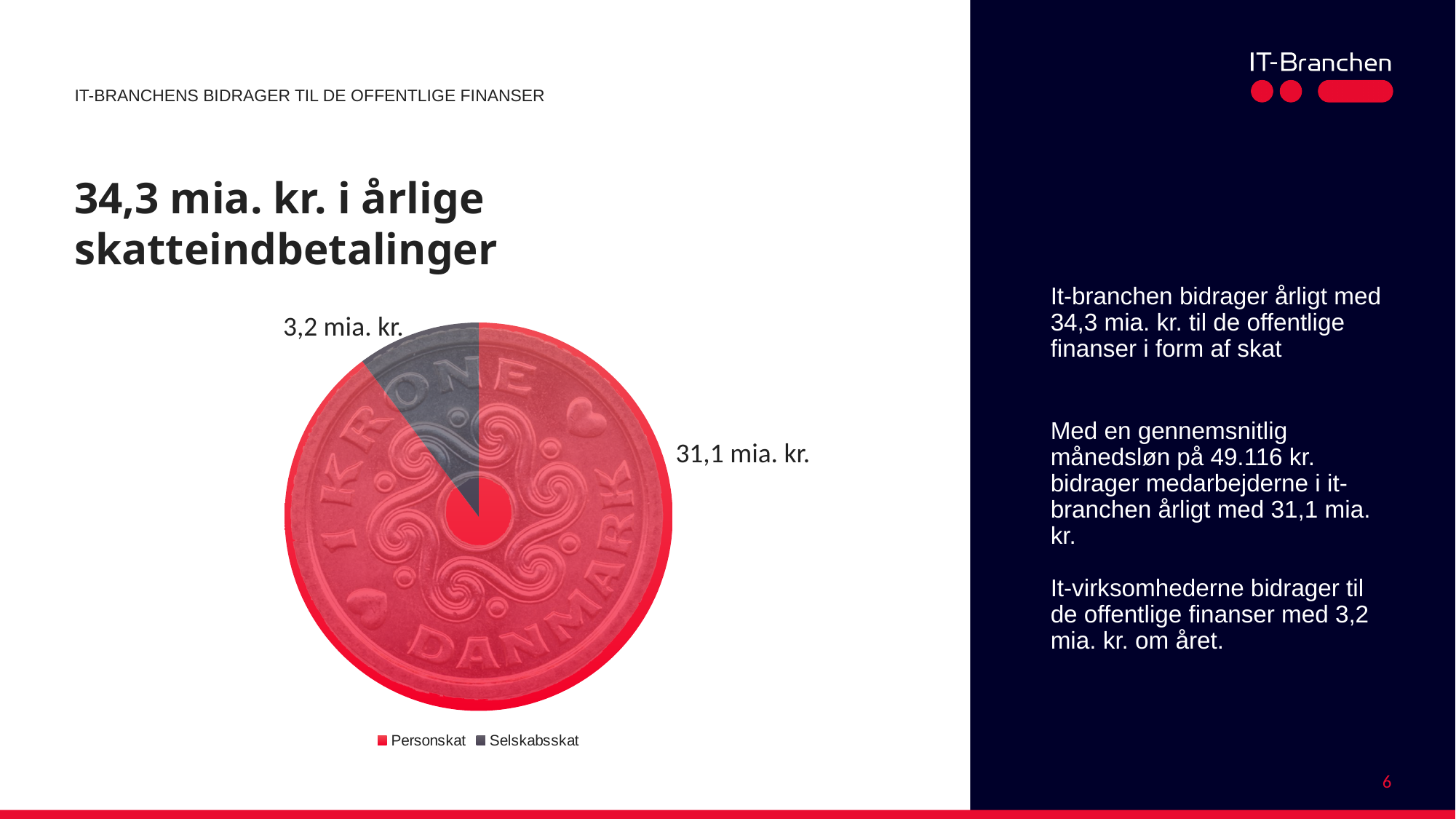
Which slice of the pie chart is the largest? Personskat What is the heading above the pie chart? 34,3 mia. kr. i årlige skatteindbetalinger How many slices does the pie chart have? 2 What is the value for Selskabsskat in the pie chart? 3,2 mia. kr. What kind of chart is shown on the slide? pie chart How many entries does the legend of the pie chart list? 2 Which is larger, Personskat or Selskabsskat? Personskat What is the difference between the Personskat and Selskabsskat values? 27,9 mia. kr. What is the total of the two slices in the pie chart? 34,3 mia. kr. Which slice of the pie chart is the smallest? Selskabsskat What is the value for Personskat in the pie chart? 31,1 mia. kr. What colour is the Selskabsskat slice in the pie chart? dark grey